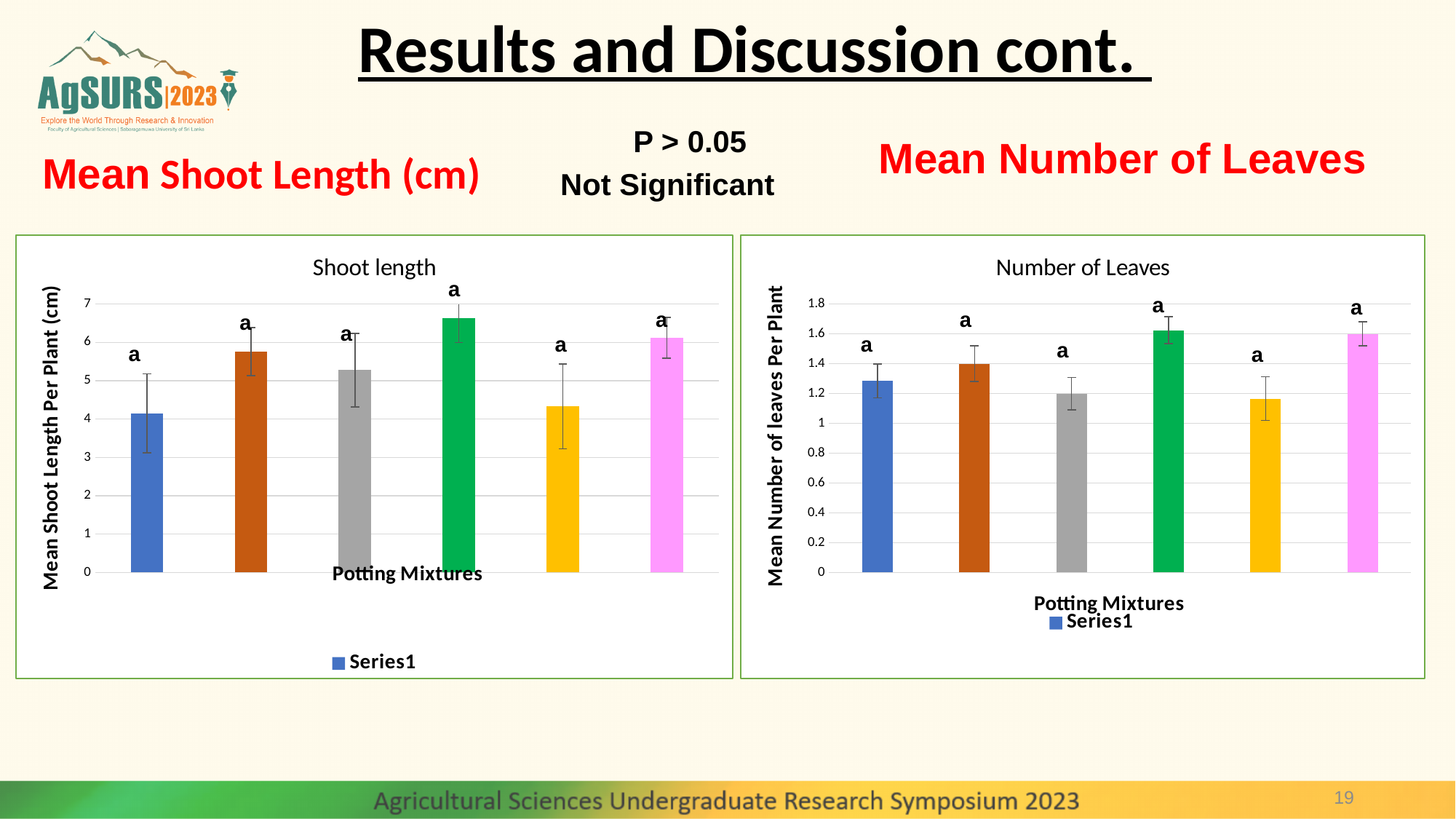
In the "Shoot length" chart, which bar is the highest? the green bar (fourth bar) In the "Number of Leaves" chart, is the value of the yellow (fifth) bar greater or less than 1.4? less How many bars are plotted in the "Shoot length" chart? 6 In the "Shoot length" chart, is the value of the green (fourth) bar greater or less than 6? greater What is the y-axis label of the "Number of Leaves" chart? Mean Number of leaves Per Plant What kind of chart is the "Shoot length" chart? bar chart In the "Shoot length" chart, is the value of the blue (first) bar greater or less than 5? less In the "Shoot length" chart, which is larger, the green (fourth) bar or the blue (first) bar? the green bar What is the x-axis label of the "Shoot length" chart? Potting Mixtures How many series does the legend of the "Number of Leaves" chart list? 1 In the "Number of Leaves" chart, which is larger, the orange (second) bar or the gray (third) bar? the orange bar